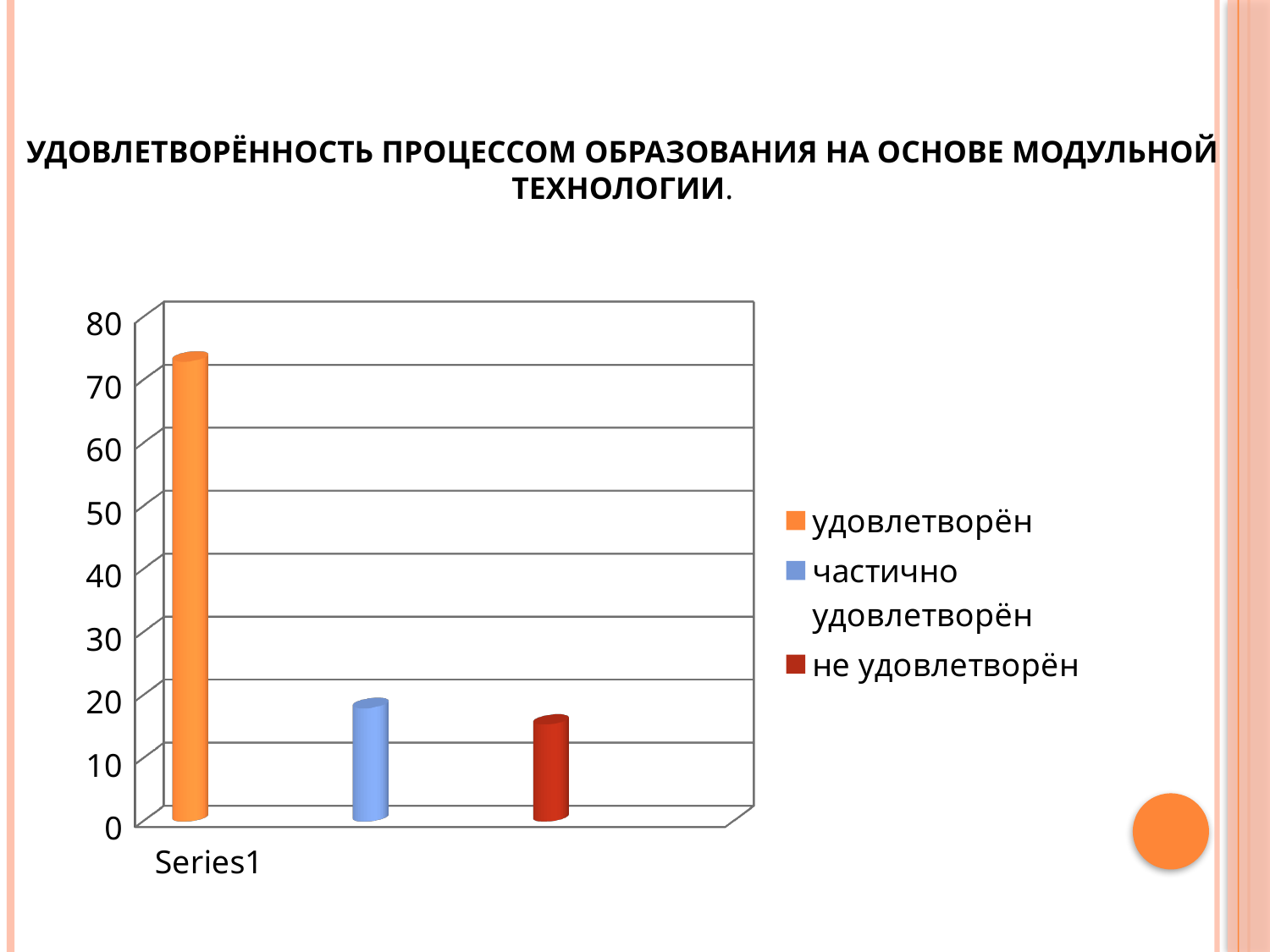
How many series does the legend list? 3 How many bars are plotted in the chart? 3 Which series has the highest value? удовлетворён Is the value for частично удовлетворён greater or less than 30? less Is the value for не удовлетворён greater or less than 10? greater What colour is the bar for не удовлетворён? dark red Which series has the lowest value? не удовлетворён Which is larger, the value for удовлетворён or the value for частично удовлетворён? удовлетворён What kind of chart is shown on the slide? bar chart Is the value for удовлетворён greater or less than 60? greater What is the title of the slide above the chart? УДОВЛЕТВОРЁННОСТЬ ПРОЦЕССОМ ОБРАЗОВАНИЯ НА ОСНОВЕ МОДУЛЬНОЙ ТЕХНОЛОГИИ. Which is larger, the value for частично удовлетворён or the value for не удовлетворён? частично удовлетворён